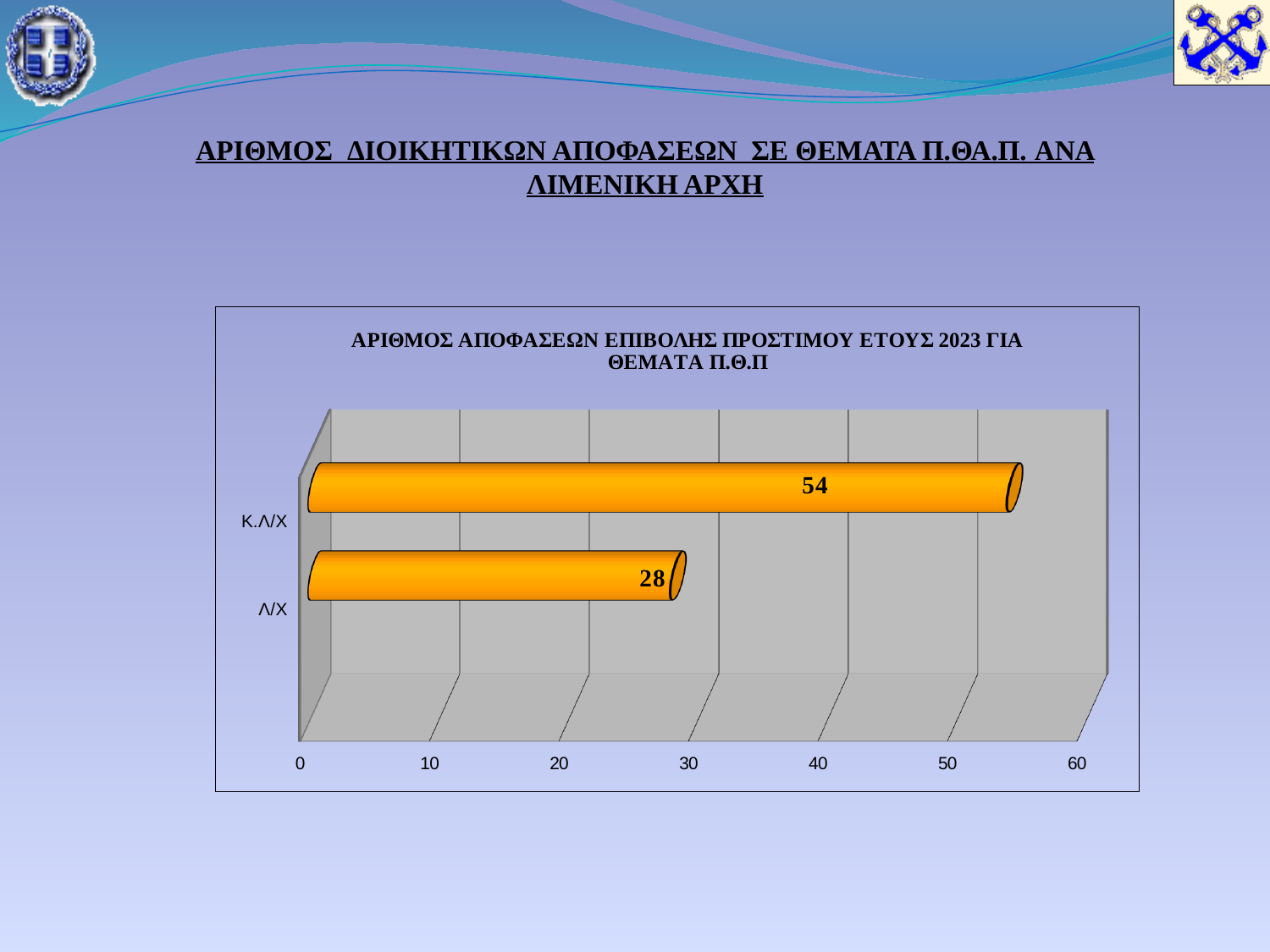
Is the value for Κ.Λ/Χ greater or less than 50? greater Which category has the lowest value? Λ/Χ What is the value for Λ/Χ? 28 How many categories are shown in the chart? 2 What kind of chart is shown on the slide? bar chart What is the title of the chart? ΑΡΙΘΜΟΣ ΑΠΟΦΑΣΕΩΝ ΕΠΙΒΟΛΗΣ ΠΡΟΣΤΙΜΟΥ ΕΤΟΥΣ 2023 ΓΙΑ ΘΕΜΑΤΑ Π.Θ.Π Which category has the highest value? Κ.Λ/Χ What is the value for Κ.Λ/Χ? 54 What is the maximum value shown on the horizontal axis? 60 Which is larger, the value for Κ.Λ/Χ or the value for Λ/Χ? Κ.Λ/Χ Is the value for Λ/Χ greater or less than 30? less What is the difference between the values for Κ.Λ/Χ and Λ/Χ? 26